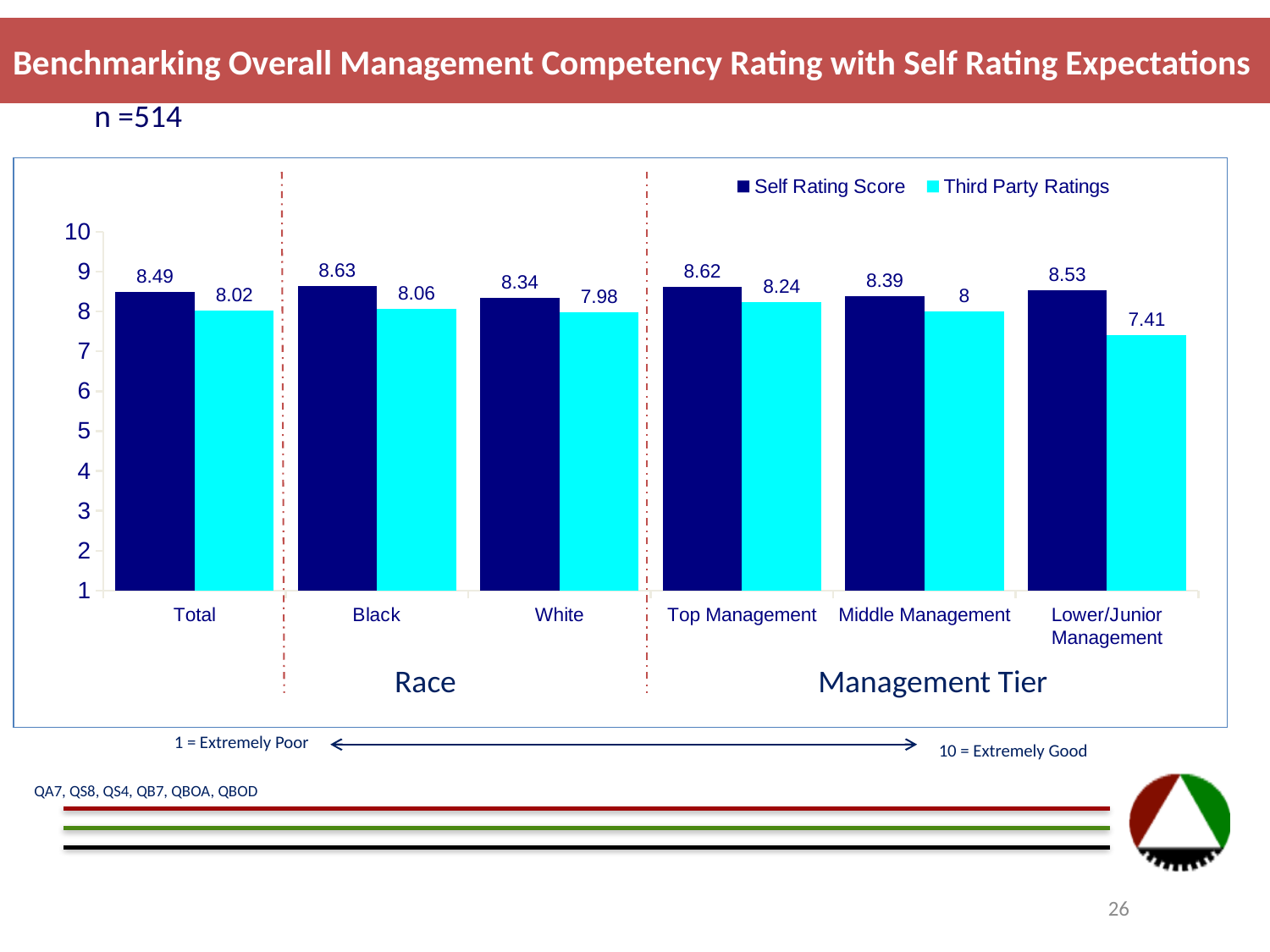
Which is larger, the Third Party Ratings for Black or for White? Black How many categories are shown on the x axis? 6 Which category has the highest Self Rating Score? Black What kind of chart is shown on the slide? Bar chart What is the Third Party Ratings value for Lower/Junior Management? 7.41 What is the difference between the Self Rating Score and the Third Party Ratings for Lower/Junior Management? 1.12 Which category has the lowest Third Party Ratings value? Lower/Junior Management What is the Third Party Ratings value for Middle Management? 8 What is the sample size (n) stated on the slide? 514 Which colour represents the Third Party Ratings series? Cyan What is the Self Rating Score for Total? 8.49 How many series does the legend list? 2